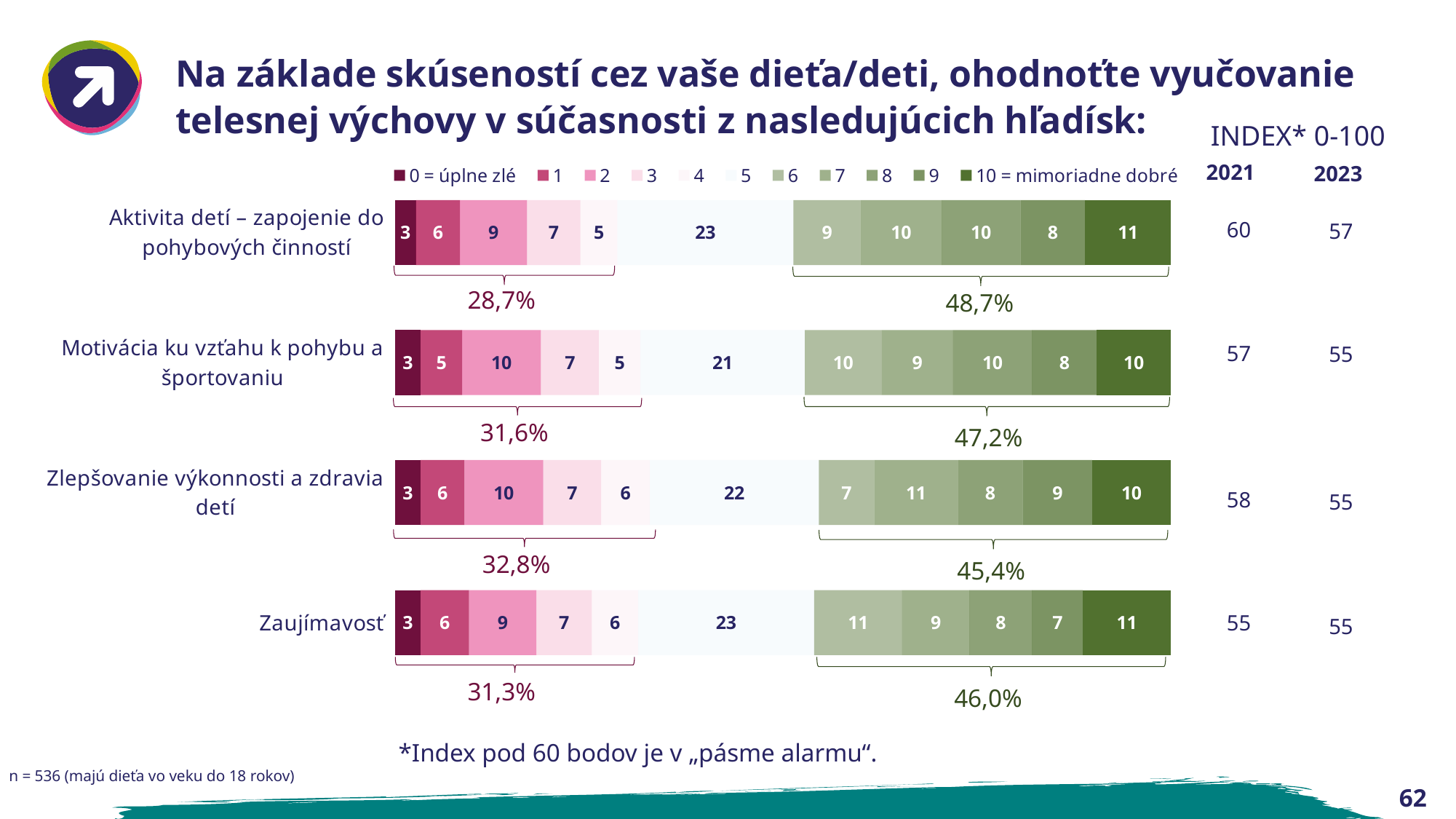
What kind of chart is shown on the slide? stacked bar chart What is the value of the '10 = mimoriadne dobré' segment for 'Zaujímavosť'? 11 Which segment is the largest in the 'Motivácia ku vzťahu k pohybu a športovaniu' bar? 5 How many series does the legend list? 11 What is the 2023 index value for 'Aktivita detí – zapojenie do pohybových činností'? 57 What percentage is shown under the pink (0–4) bracket for 'Zlepšovanie výkonnosti a zdravia detí'? 32,8% For 'Zaujímavosť', which is larger: the pink bracket share (31,3%) or the green bracket share (46,0%)? 46,0% What percentage is shown under the green (6–10) bracket for 'Motivácia ku vzťahu k pohybu a športovaniu'? 47,2% By how much did the index for 'Aktivita detí – zapojenie do pohybových činností' fall from 2021 to 2023? 3 What is the value of the '5' segment for 'Aktivita detí – zapojenie do pohybových činností'? 23 How many categories (rows) does the chart show? 4 What is the value of the '7' segment for 'Zlepšovanie výkonnosti a zdravia detí'? 11